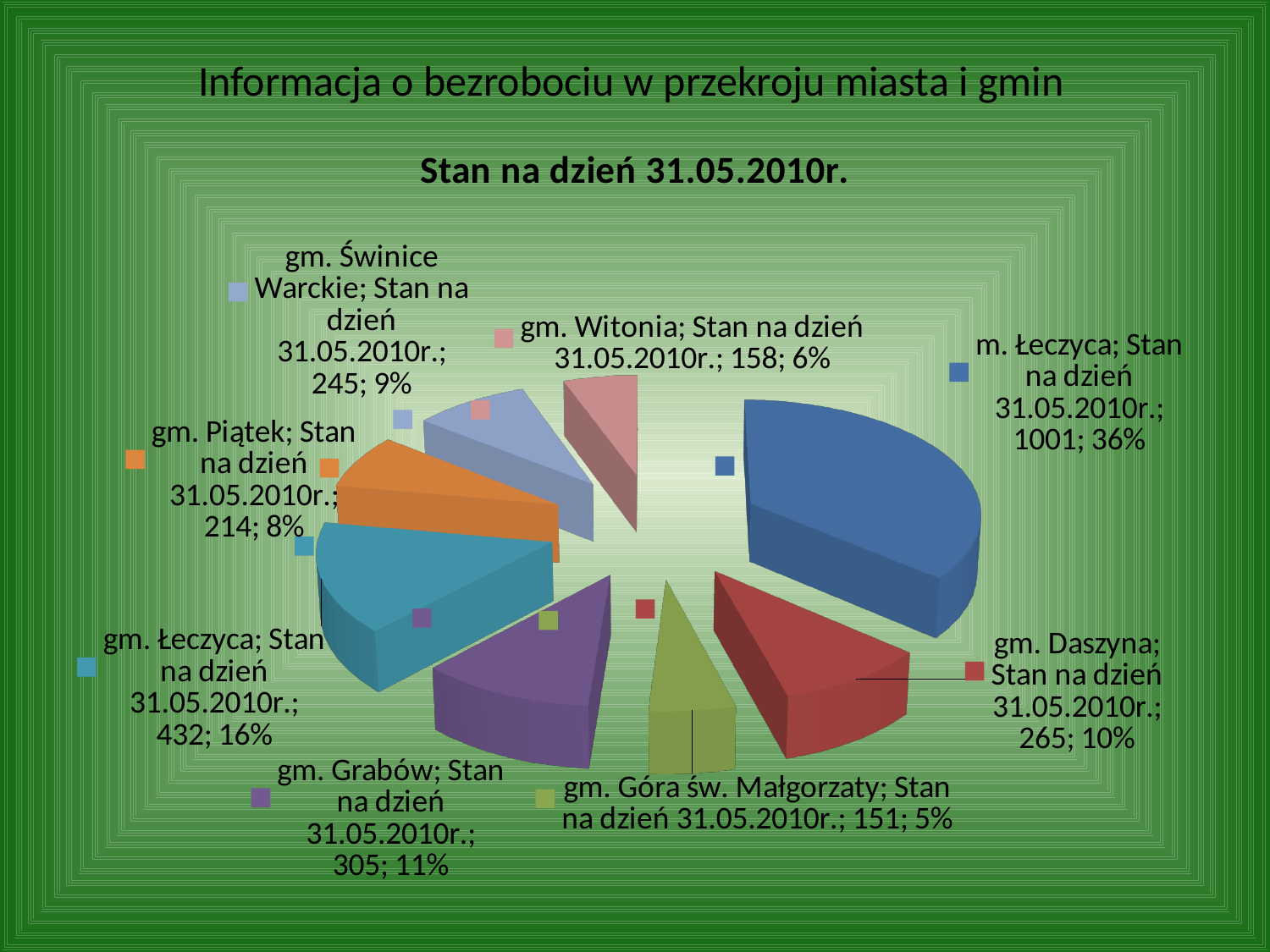
How many slices does the pie chart have? 8 Which category has the smallest slice? gm. Góra św. Małgorzaty What is the value for gm. Łeczyca? 432 Which is larger, the value for gm. Piątek or the value for gm. Świnice Warckie? gm. Świnice Warckie What share of the pie does gm. Daszyna represent? 10% What kind of chart is shown on the slide? pie chart What share of the pie does gm. Świnice Warckie represent? 9% What is the value for gm. Grabów? 305 What is the value for m. Łeczyca? 1001 Which category has the largest slice? m. Łeczyca What is the difference between the values for m. Łeczyca and gm. Łeczyca? 569 What is the value for gm. Witonia? 158